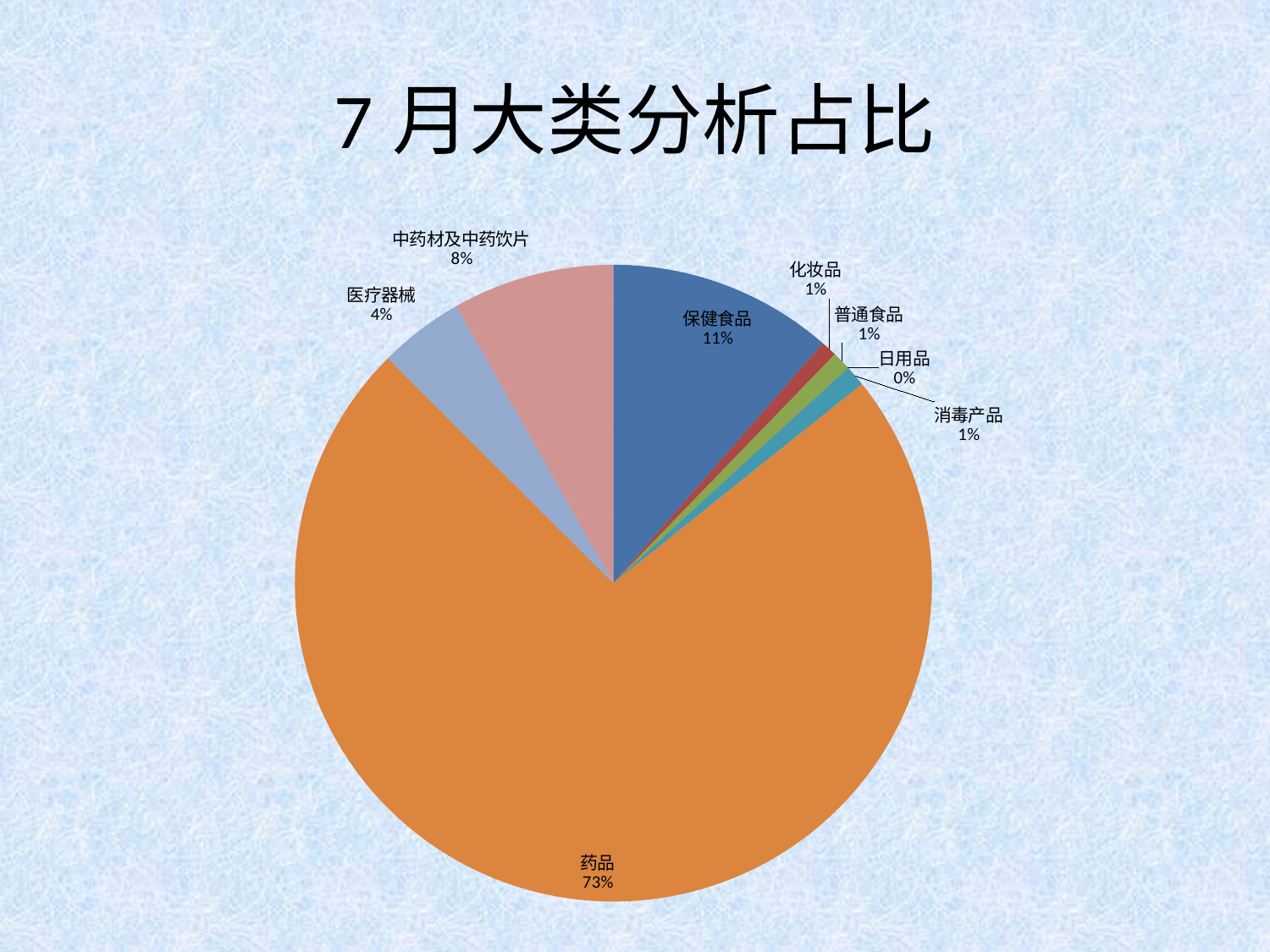
What is the value shown for 保健食品? 11% What is the value shown for 中药材及中药饮片? 8% What kind of chart is shown on the slide? Pie chart What is the value shown for 日用品? 0% Which category has the largest slice of the pie? 药品 What is the title of the chart? 7月大类分析占比 What share of the pie does 药品 account for? 73% What is the difference between the shares of 药品 and 保健食品? 62% How many categories are shown in the pie chart? 8 Which category has the smallest slice of the pie? 日用品 Which is larger, the share of 中药材及中药饮片 or the share of 医疗器械? 中药材及中药饮片 What is the value shown for 医疗器械? 4%